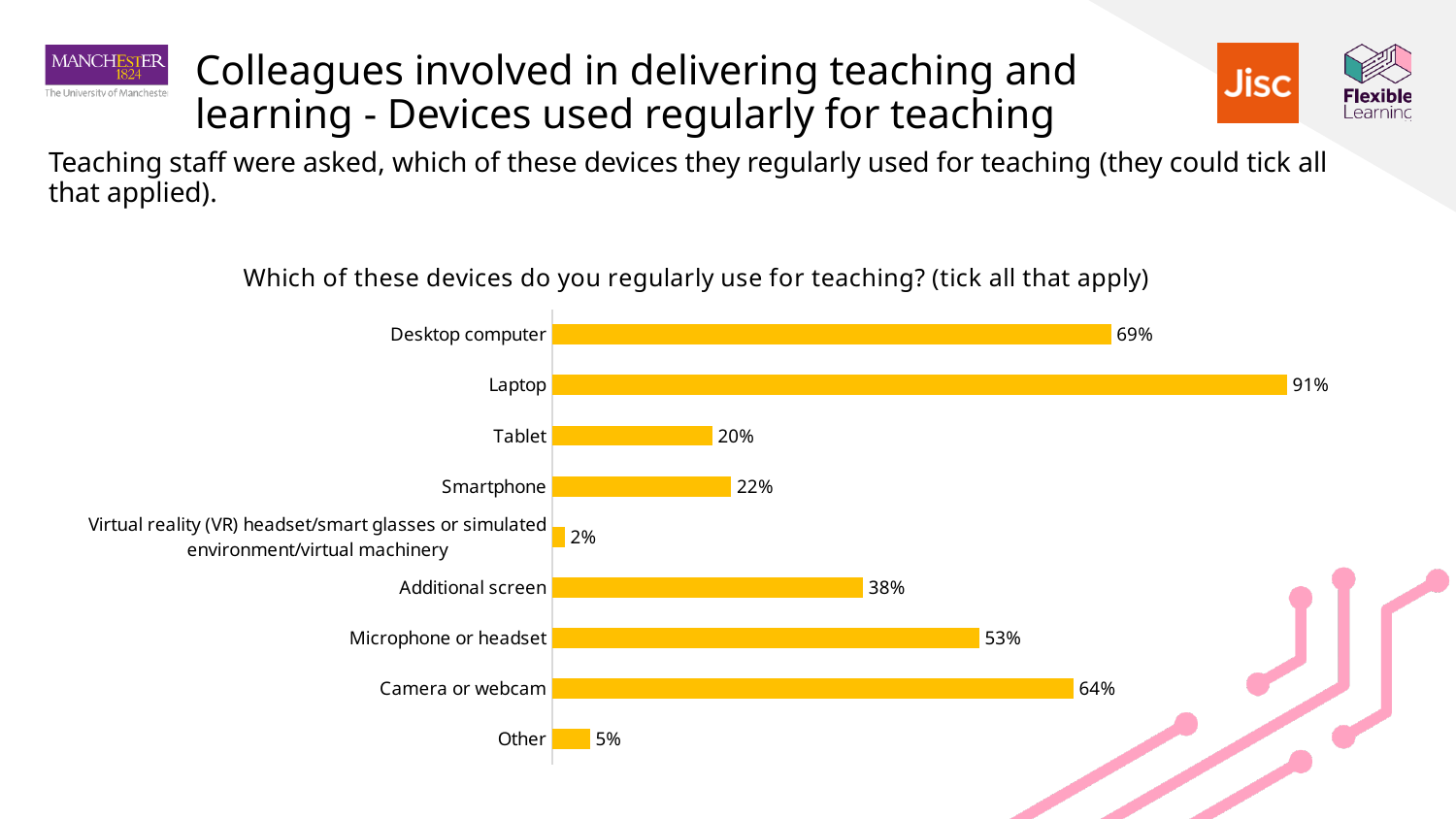
What percentage is shown for Additional screen? 38% What colour are the bars in the chart? Yellow What is the difference between the values for Smartphone and Tablet? 2% What percentage of teaching staff regularly use a laptop for teaching? 91% Which category has the lowest value on the chart? Virtual reality (VR) headset/smart glasses or simulated environment/virtual machinery What is the title of the chart? Which of these devices do you regularly use for teaching? (tick all that apply) Which is larger, the value for Microphone or headset or the value for Additional screen? Microphone or headset Which device has the highest percentage of regular use for teaching? Laptop How many device categories are shown on the chart? 9 What type of chart is shown on the slide? Bar chart What is the difference between the percentages for Laptop and Desktop computer? 22% What is the value shown for Camera or webcam? 64%